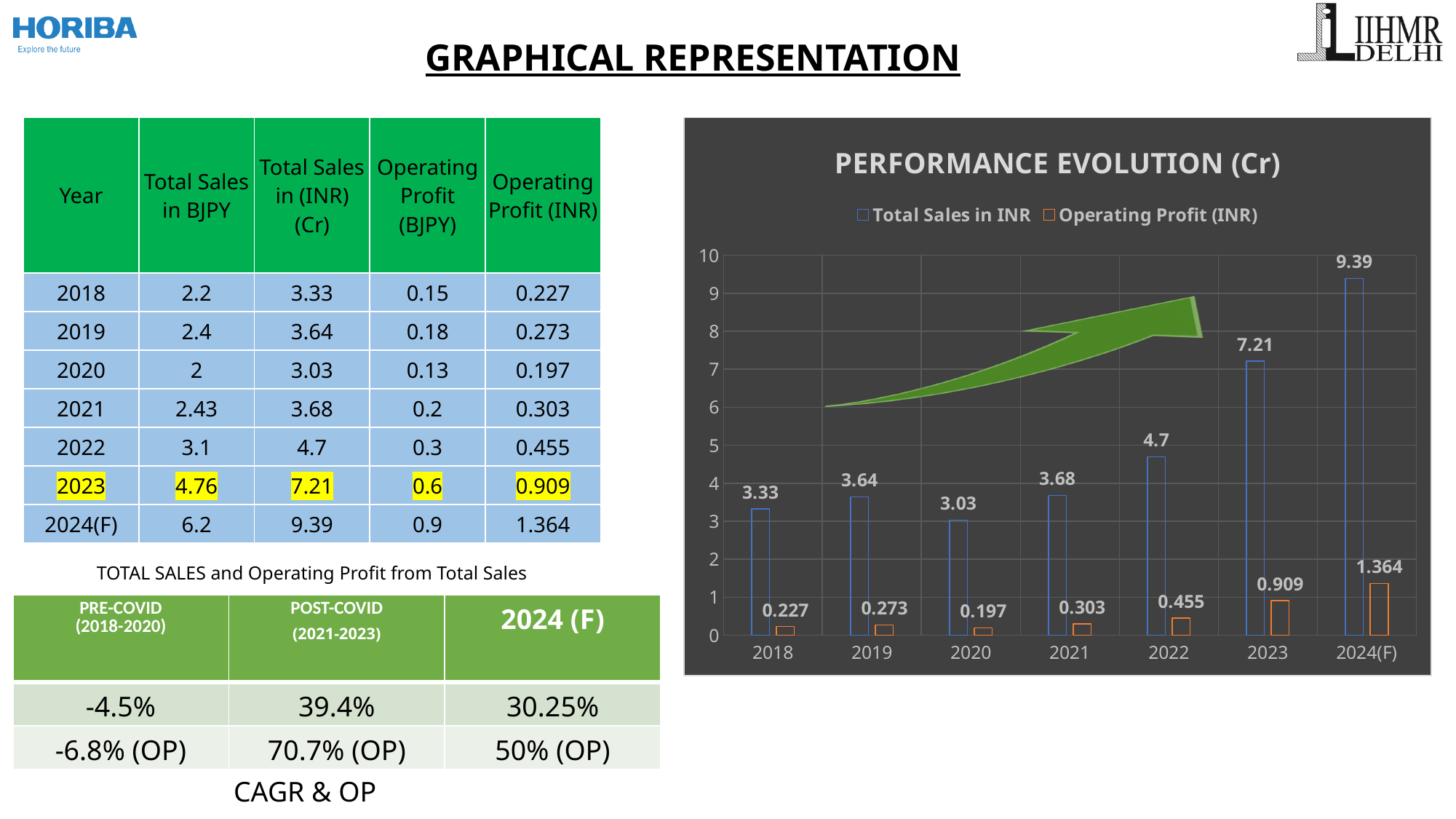
What type of chart is the Performance Evolution chart? bar chart How many series does the legend of the Performance Evolution chart list? 2 What is the title of the chart on the slide? PERFORMANCE EVOLUTION (Cr) Which year has the highest Total Sales in INR in the Performance Evolution chart? 2024(F) Which year has the lowest Operating Profit (INR) in the Performance Evolution chart? 2020 Is Total Sales in INR higher in 2019 or in 2020 in the Performance Evolution chart? 2019 What is the difference between Total Sales in INR for 2023 and 2022 in the Performance Evolution chart? 2.51 What is the Operating Profit (INR) value for 2021 in the Performance Evolution chart? 0.303 What is the Total Sales in INR value for 2022 in the Performance Evolution chart? 4.7 How many years are shown on the x axis of the Performance Evolution chart? 7 Does Total Sales in INR rise or fall from 2020 to 2024(F) in the Performance Evolution chart? rise Is the Total Sales in INR value for 2024(F) greater or less than 9? greater